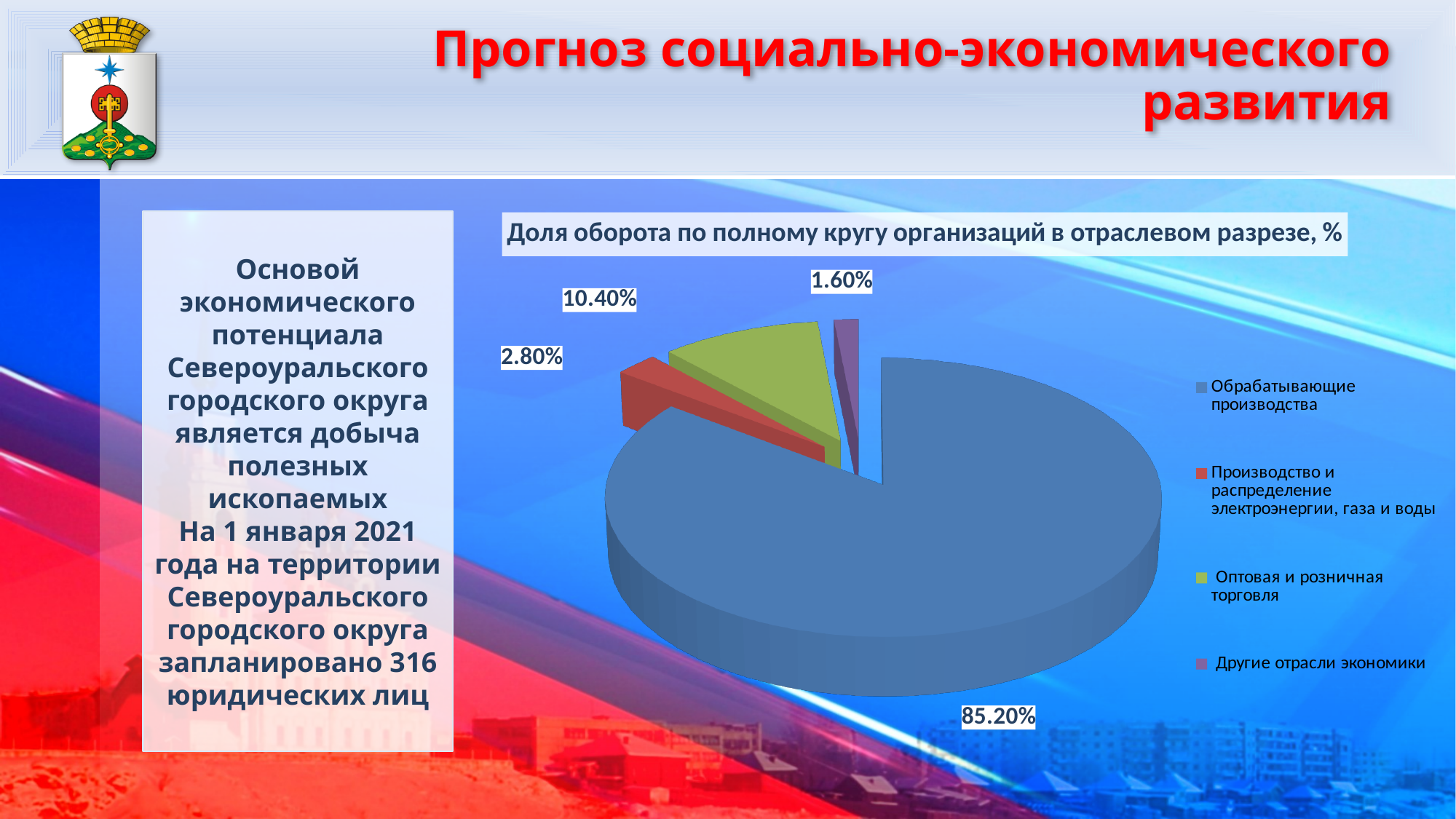
What is the share for Производство и распределение электроэнергии, газа и воды? 2.80% What is the share for Другие отрасли экономики? 1.60% Which is larger: the share for Оптовая и розничная торговля or for Производство и распределение электроэнергии, газа и воды? Оптовая и розничная торговля Which colour represents Оптовая и розничная торговля in the pie chart? Green What is the difference between the shares of Обрабатывающие производства and Оптовая и розничная торговля? 74.80% What is the share for Оптовая и розничная торговля? 10.40% What is the share for Обрабатывающие производства? 85.20% What type of chart is shown on the slide? Pie chart How many slices does the pie chart have? 4 Which category has the largest share of the pie? Обрабатывающие производства What is the title of the chart? Доля оборота по полному кругу организаций в отраслевом разрезе, % Which category has the smallest share of the pie? Другие отрасли экономики